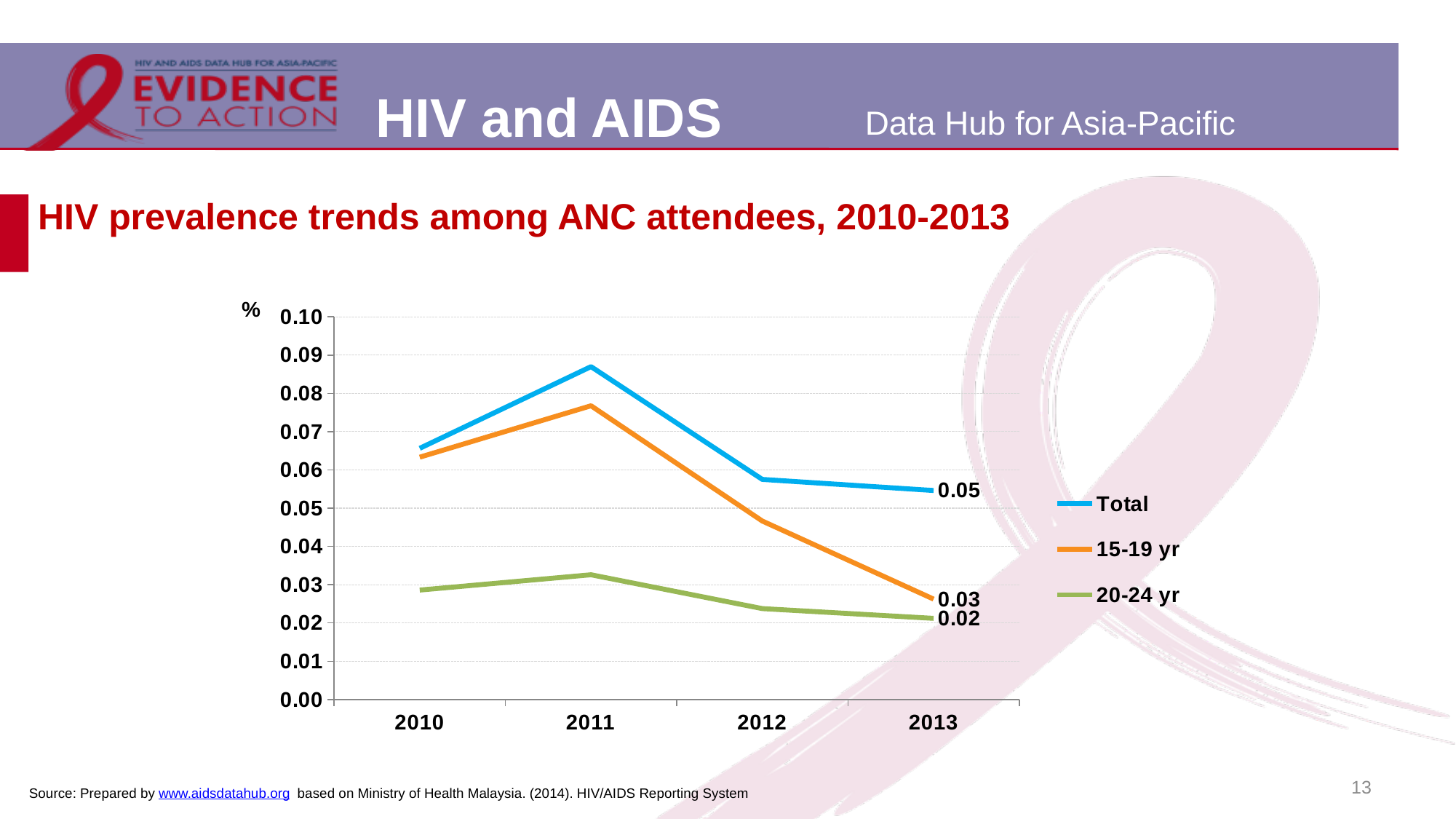
How many years are shown on the x axis? 4 What is the value for the Total series in 2013? 0.05 What is the value for the 15-19 yr series in 2013? 0.03 Is the value for the Total series in 2011 greater or less than 0.08? greater Which series has the lowest value in 2013? 20-24 yr What kind of chart is shown on the slide? line chart What is the difference between the Total and the 15-19 yr values in 2013? 0.03 In 2013, which is larger: the Total value or the 20-24 yr value? Total What is the value for the 20-24 yr series in 2013? 0.02 Is the value for the 20-24 yr series in 2010 greater or less than 0.04? less How many series does the legend list? 3 In which year does the Total series reach its highest value? 2011